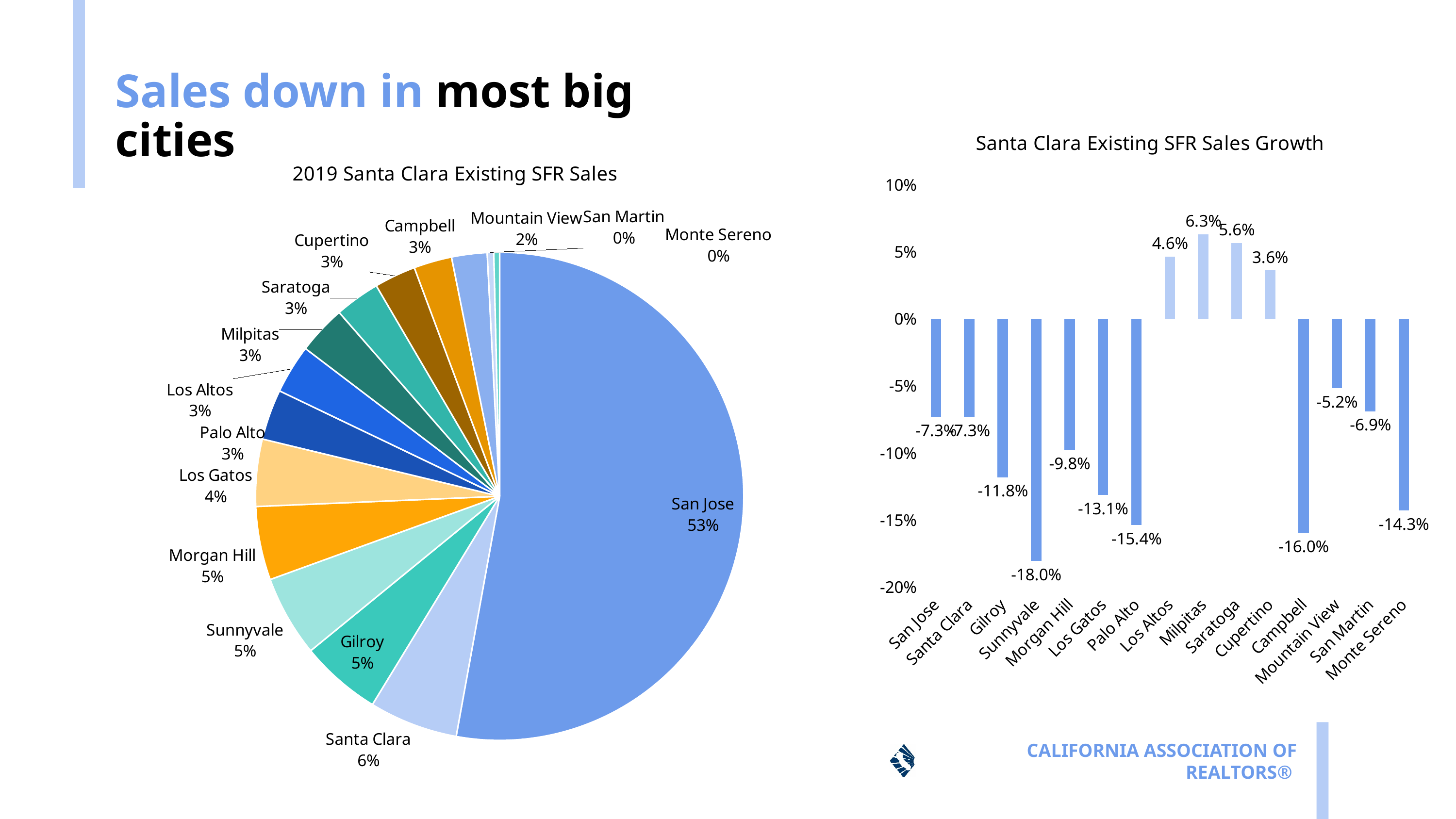
In the bar chart 'Santa Clara Existing SFR Sales Growth', what is the value for Sunnyvale? -18.0% What type of chart is the chart on the right of the slide? Bar chart In the bar chart 'Santa Clara Existing SFR Sales Growth', which city has the highest value? Milpitas In the pie chart '2019 Santa Clara Existing SFR Sales', what is the share for Santa Clara? 6% What type of chart is the chart on the left of the slide? Pie chart In the bar chart 'Santa Clara Existing SFR Sales Growth', what is the difference between the values for Milpitas and Cupertino? 2.7% How many slices does the pie chart '2019 Santa Clara Existing SFR Sales' have? 15 In the bar chart 'Santa Clara Existing SFR Sales Growth', which is larger, the value for Campbell or the value for Monte Sereno? Monte Sereno In the bar chart 'Santa Clara Existing SFR Sales Growth', which city has the lowest value? Sunnyvale In the bar chart 'Santa Clara Existing SFR Sales Growth', what is the value for Milpitas? 6.3% In the pie chart '2019 Santa Clara Existing SFR Sales', which city has the largest slice? San Jose In the pie chart '2019 Santa Clara Existing SFR Sales', what share of sales does San Jose account for? 53%